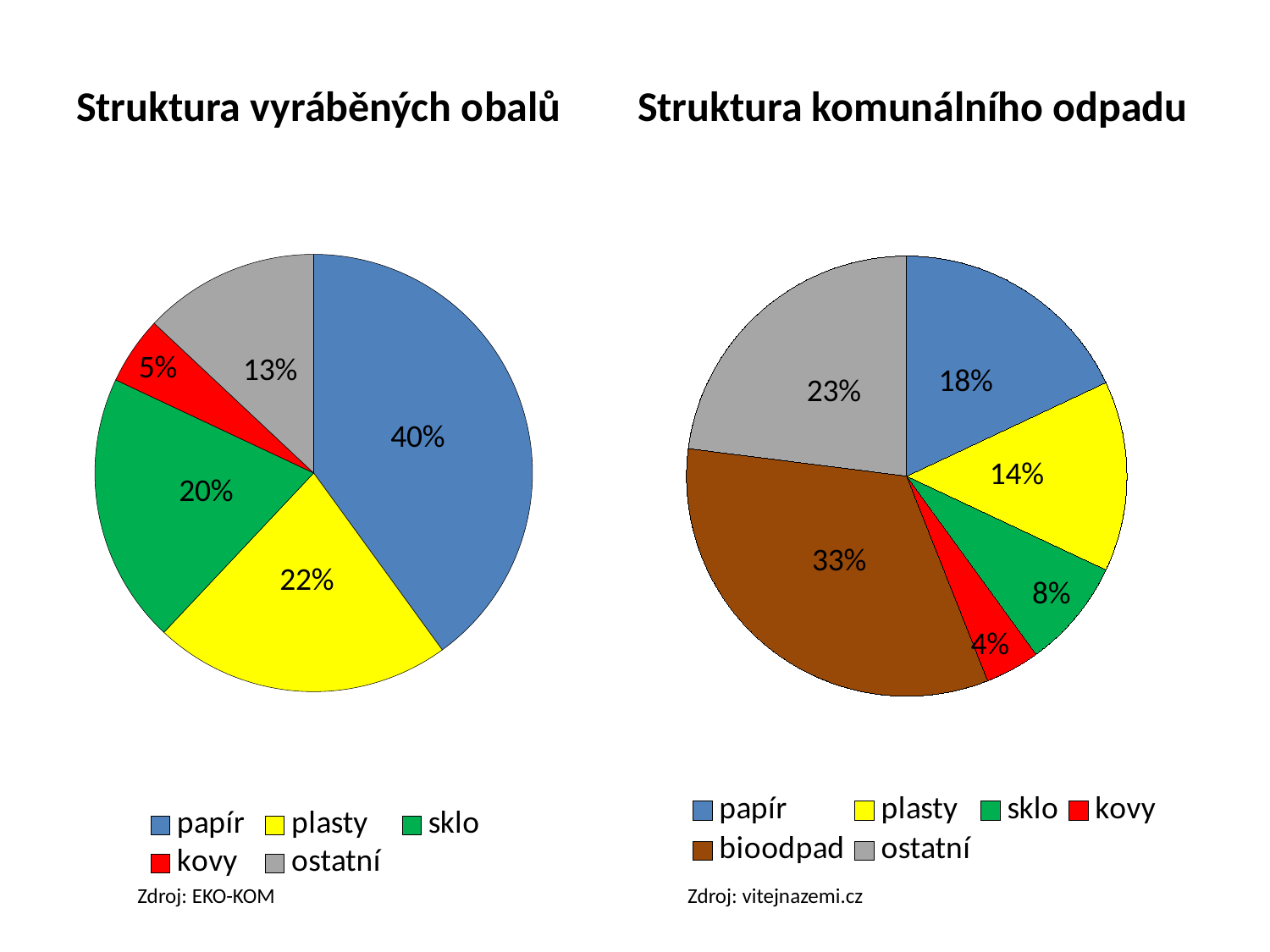
In the 'Struktura komunálního odpadu' chart, what share does bioodpad have? 33% In the 'Struktura vyráběných obalů' chart, which category has the largest share? papír Which category appears in the legend of the 'Struktura komunálního odpadu' chart but not in the legend of the 'Struktura vyráběných obalů' chart? bioodpad How many entries does the legend of the 'Struktura vyráběných obalů' chart list? 5 In the 'Struktura vyráběných obalů' chart, what colour is the kovy slice? red How many slices does the 'Struktura komunálního odpadu' chart have? 6 In the 'Struktura vyráběných obalů' chart, what is the difference between the shares of plasty and sklo? 2% In the 'Struktura vyráběných obalů' chart, what share does papír have? 40% What kind of chart is 'Struktura vyráběných obalů'? pie chart In the 'Struktura komunálního odpadu' chart, which is larger, the share of papír or the share of plasty? papír In the 'Struktura komunálního odpadu' chart, what share does ostatní have? 23% In the 'Struktura komunálního odpadu' chart, which category has the smallest share? kovy